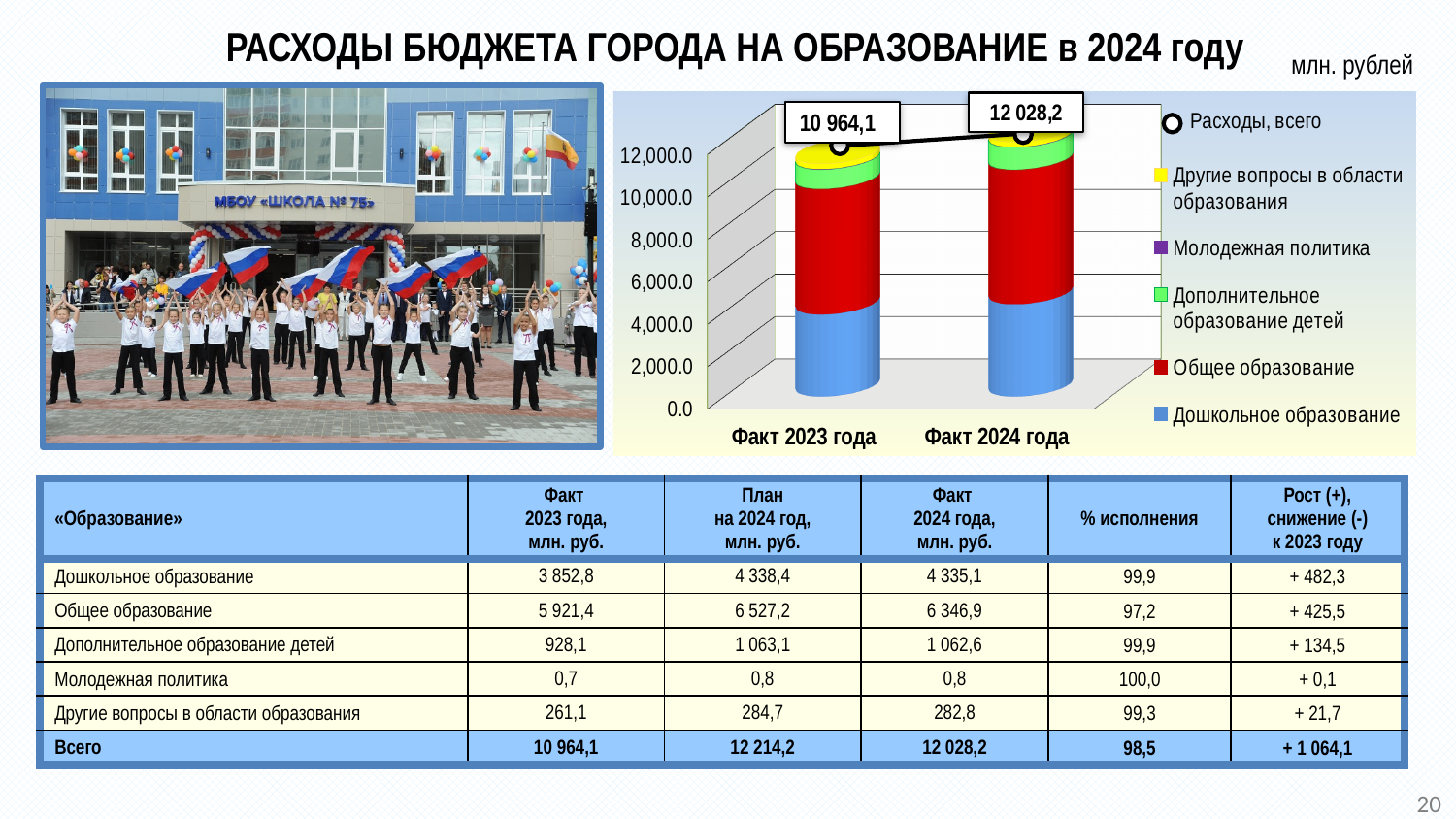
Do the total expenditures rise or fall from Факт 2023 года to Факт 2024 года? rise Which category has the larger total: Факт 2023 года or Факт 2024 года? Факт 2024 года What colour represents Общее образование in the chart? red What is the total value (Расходы, всего) labelled for Факт 2024 года? 12 028,2 What is the total value (Расходы, всего) labelled for Факт 2023 года? 10 964,1 Which legend entry is shown with a circle marker rather than a coloured square? Расходы, всего Is the total for Факт 2024 года greater or less than 12,000.0? greater Is the total for Факт 2023 года greater or less than 10,000.0? greater How many categories are shown on the x axis of the chart? 2 By how much does the labelled total for Факт 2024 года exceed the total for Факт 2023 года? 1 064,1 How many entries does the chart legend list? 6 What kind of chart is shown on the slide? stacked bar chart